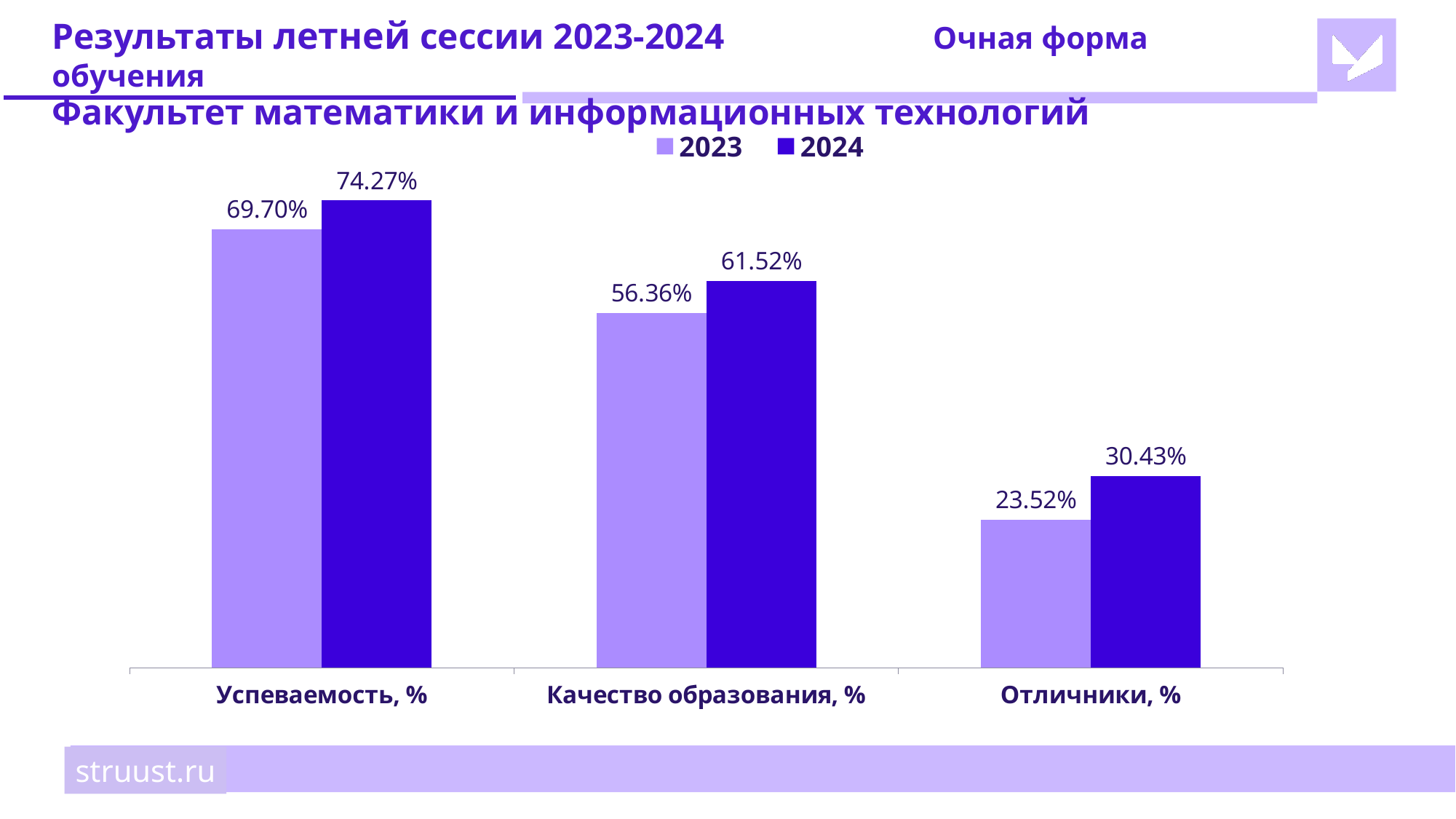
What is the difference between the 2024 and 2023 values for Успеваемость, %? 4.57% What is the value for 2023 in the Качество образования, % category? 56.36% What is the value for 2024 in the Успеваемость, % category? 74.27% What is the difference between the 2024 and 2023 values for Отличники, %? 6.91% Which is larger for Качество образования, %: the 2023 value or the 2024 value? 2024 Which category has the highest value for the 2024 series? Успеваемость, % Which category has the lowest value for the 2023 series? Отличники, % How many categories are shown on the x axis? 3 What kind of chart is shown on the slide? Bar chart What is the value for 2023 in the Отличники, % category? 23.52% What is the value for 2024 in the Отличники, % category? 30.43% How many series does the legend list? 2